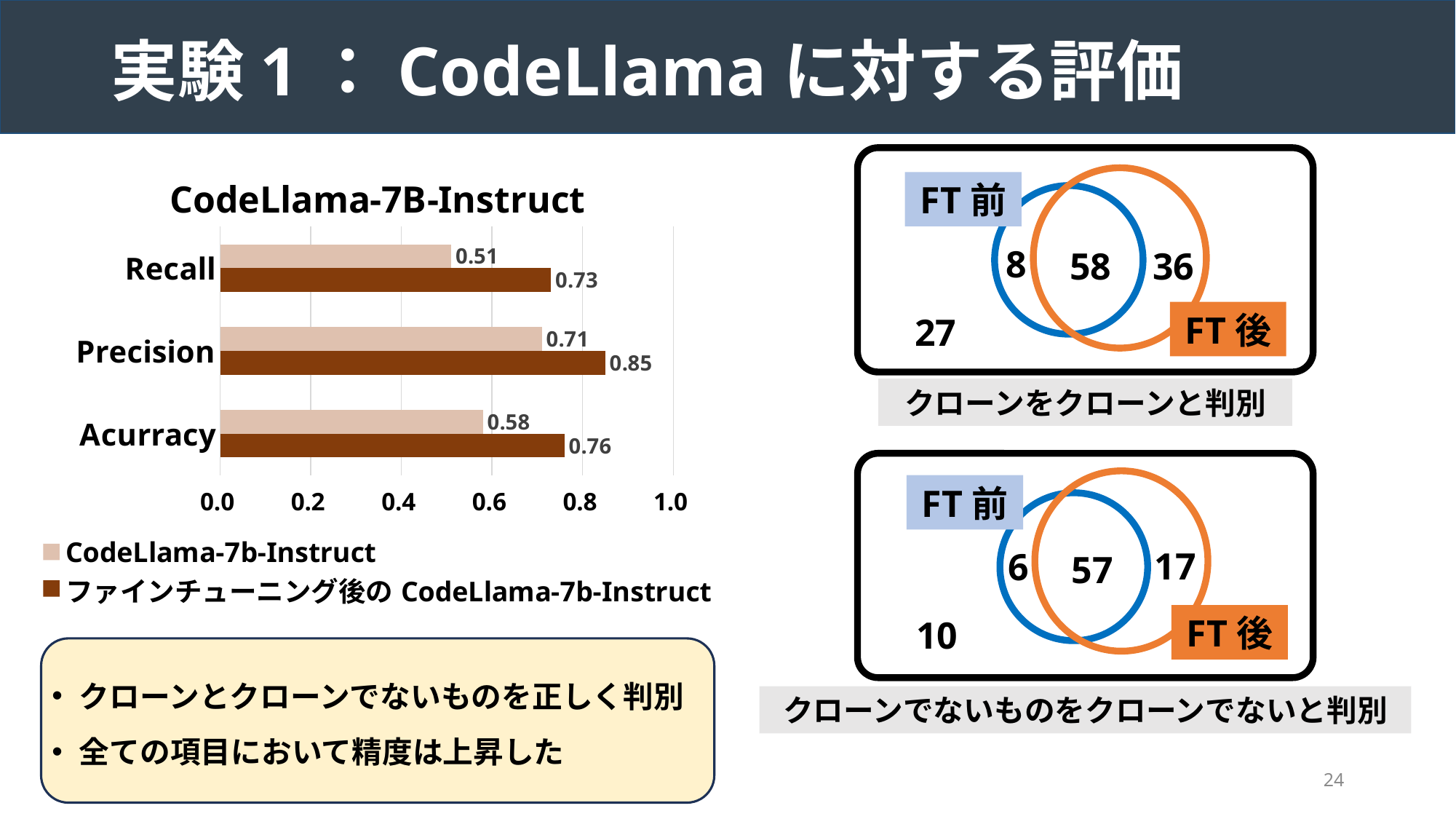
How many series does the bar chart legend list? 2 What is the difference between the Precision values of the fine-tuned and the original CodeLlama-7b-Instruct? 0.14 Which metric has the highest value for the fine-tuned CodeLlama-7b-Instruct? Precision What is the Recall value for the fine-tuned CodeLlama-7b-Instruct? 0.73 What type of chart is used to show the CodeLlama-7B-Instruct results? Bar chart How many metrics (categories) are shown on the bar chart? 3 What is the Precision value for the fine-tuned CodeLlama-7b-Instruct (ファインチューニング後)? 0.85 What is the Acurracy value for the fine-tuned CodeLlama-7b-Instruct? 0.76 Which metric has the lowest value for CodeLlama-7b-Instruct before fine-tuning? Recall What is the Recall value for CodeLlama-7b-Instruct before fine-tuning? 0.51 Which is larger: the Acurracy of the original CodeLlama-7b-Instruct or its Recall? Acurracy What is the difference between the Recall values of the fine-tuned and the original CodeLlama-7b-Instruct? 0.22